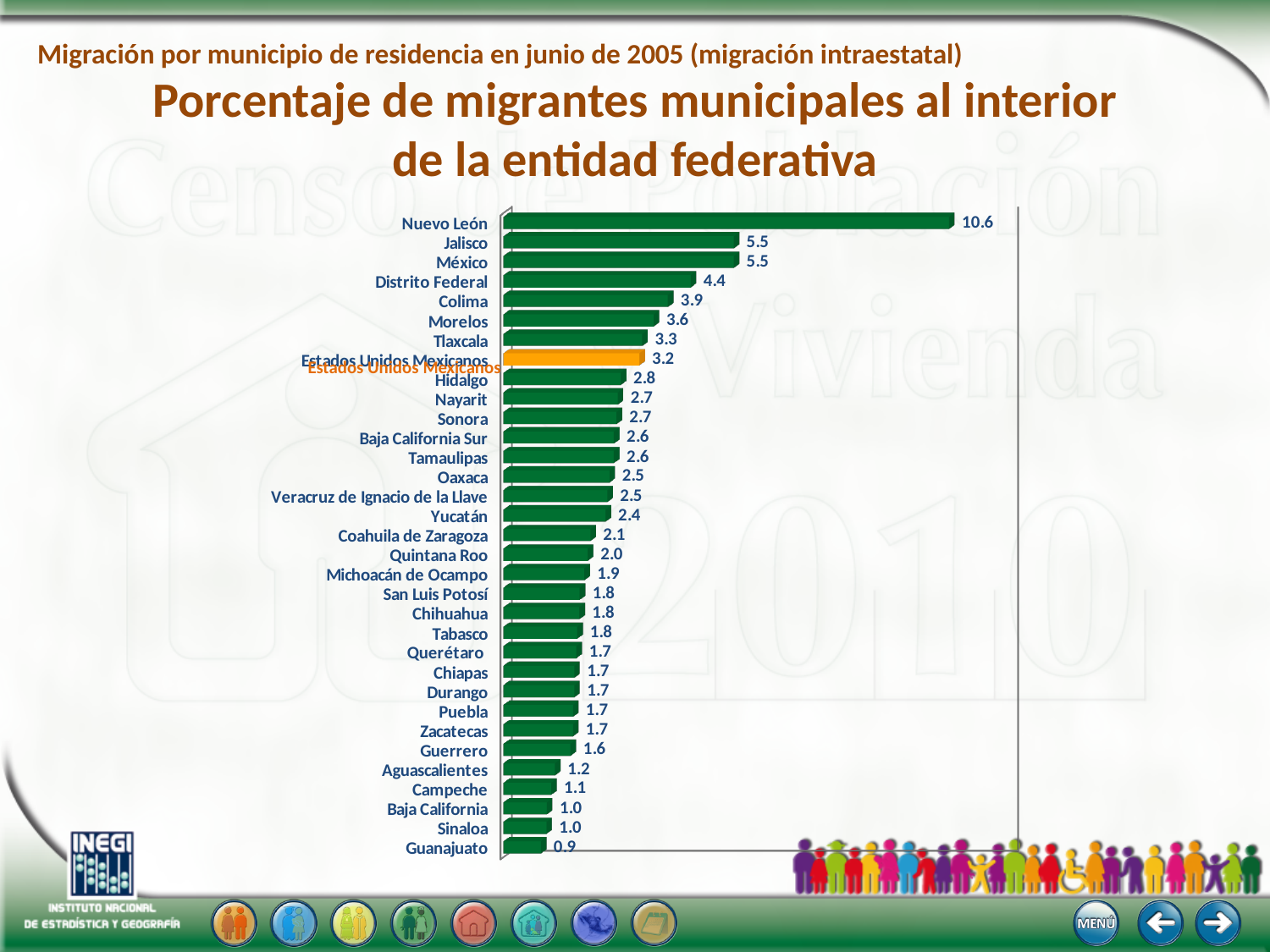
What is the difference between the values for Nuevo León and Jalisco? 5.1 What is the difference between the values for Estados Unidos Mexicanos and Hidalgo? 0.4 What is the value for Guanajuato? 0.9 What is the value for Estados Unidos Mexicanos? 3.2 Which bar is shown in a different colour (orange) from the others? Estados Unidos Mexicanos Which is larger, the value for Colima or the value for Morelos? Colima What is the value for Distrito Federal? 4.4 What is the value for Nuevo León? 10.6 What kind of chart is shown on the slide? Bar chart How many categories are shown in the chart? 33 Which category has the lowest value? Guanajuato Which category has the highest value? Nuevo León